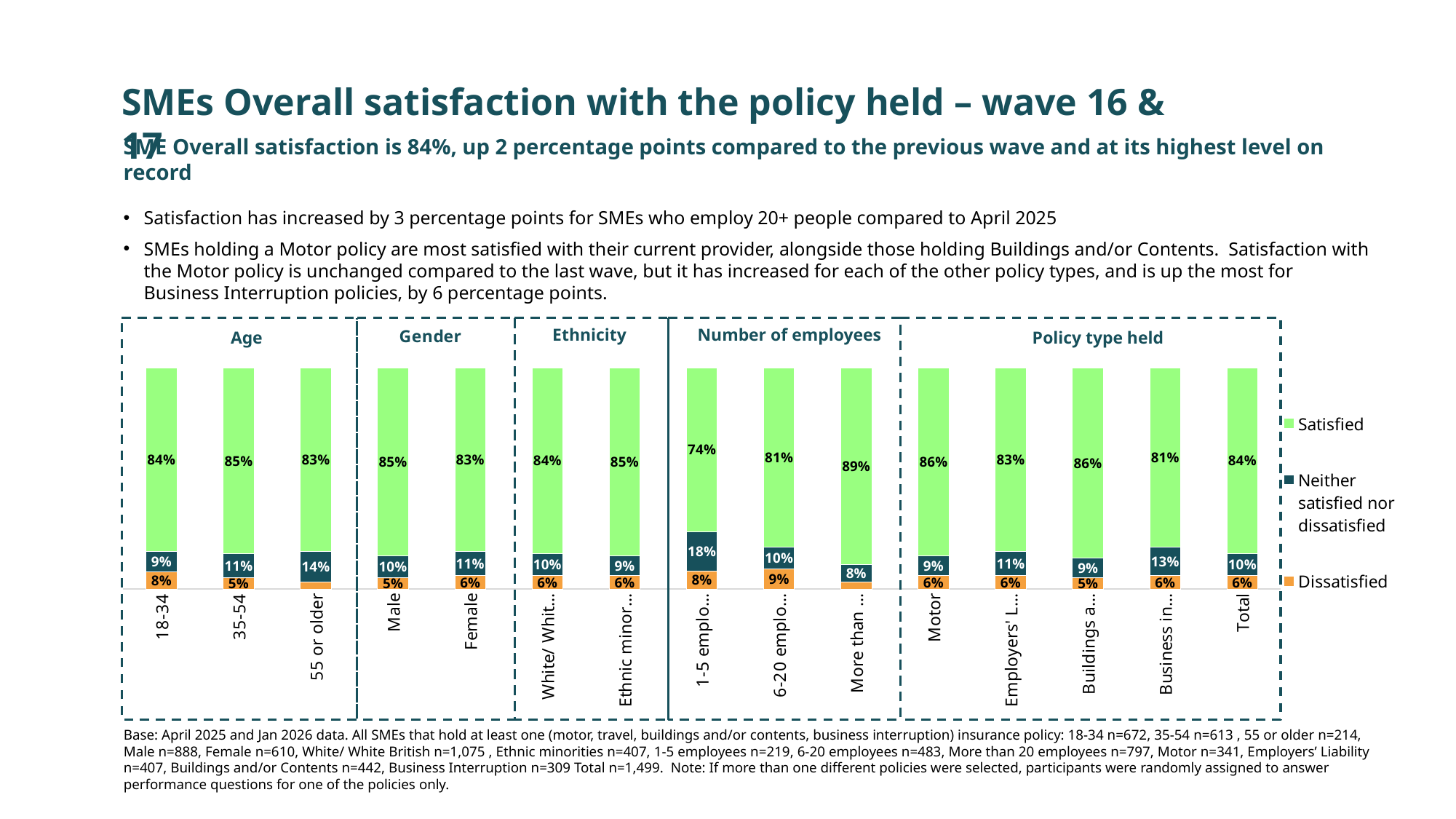
Which category has the lowest Satisfied value? 1-5 employees What is the Satisfied value for the Total category? 84% What is the Dissatisfied value for the 35-54 age group? 5% What kind of chart is shown on the slide? Stacked bar chart How many bars are plotted in the chart? 15 Which colour represents the Dissatisfied series in the chart? Orange Which category has the highest Satisfied value? More than 20 employees How many series does the legend list? 3 What percentage of SMEs aged 18-34 are satisfied? 84% Which has a higher Satisfied value, Male or Female? Male What is the difference in Satisfied values between Motor and Business Interruption policy holders? 5 percentage points What is the Neither satisfied nor dissatisfied value for SMEs with 1-5 employees? 18%